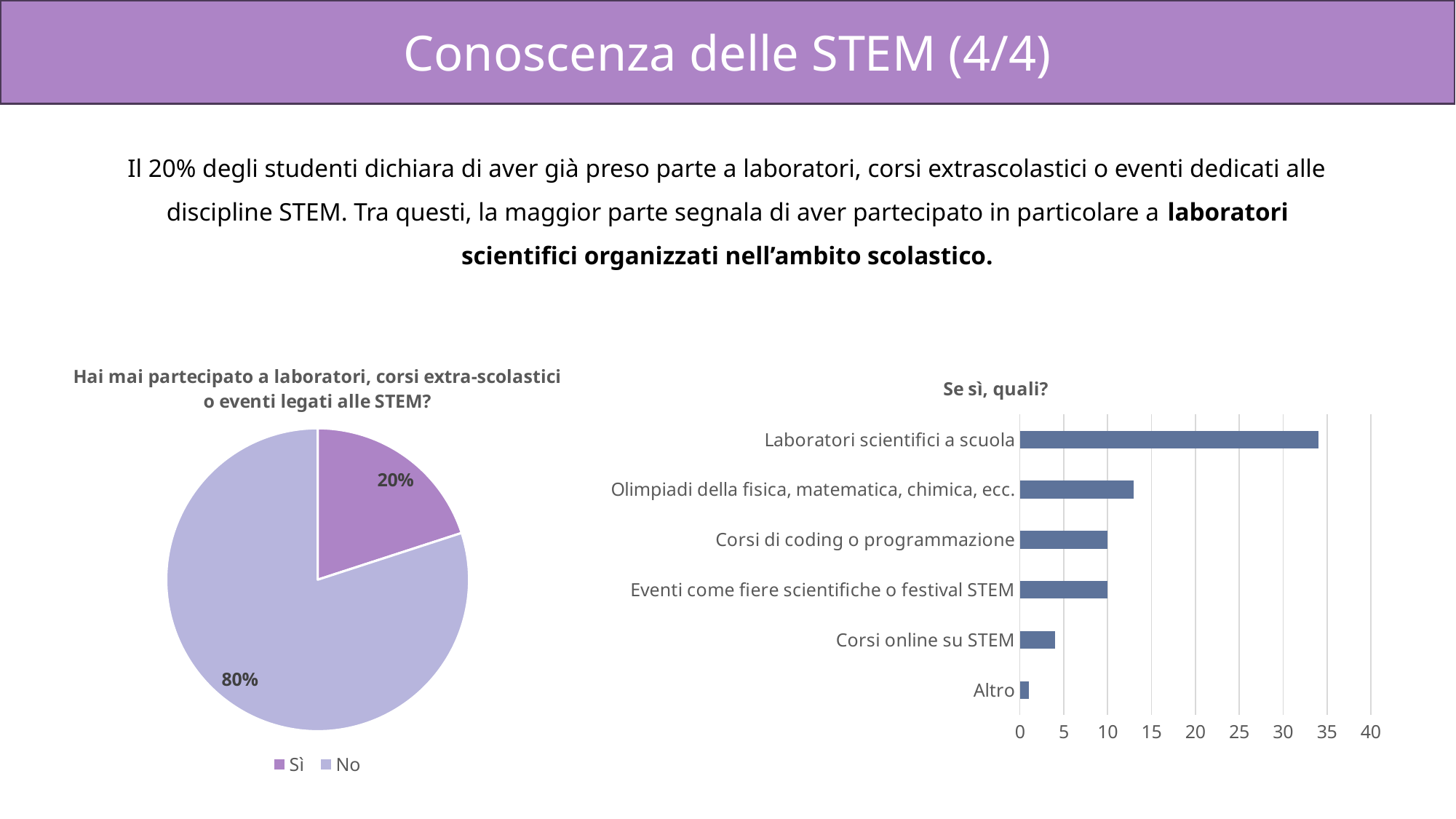
How many entries does the legend of the pie chart on the left list? 2 On the bar chart 'Se sì, quali?', is the value for 'Corsi online su STEM' greater or less than 5? less On the pie chart on the left, what is the difference in percentage points between 'No' and 'Sì'? 60 On the pie chart 'Hai mai partecipato a laboratori, corsi extra-scolastici o eventi legati alle STEM?', what percentage answered 'No'? 80% On the bar chart 'Se sì, quali?', which category has the lowest value? Altro On the bar chart 'Se sì, quali?', is the value for 'Laboratori scientifici a scuola' greater or less than 30? greater What kind of chart is the chart titled 'Se sì, quali?'? bar chart On the bar chart 'Se sì, quali?', which is larger: 'Olimpiadi della fisica, matematica, chimica, ecc.' or 'Corsi online su STEM'? Olimpiadi della fisica, matematica, chimica, ecc. How many categories are shown on the bar chart 'Se sì, quali?'? 6 On the bar chart 'Se sì, quali?', which category has the highest value? Laboratori scientifici a scuola On the pie chart 'Hai mai partecipato a laboratori, corsi extra-scolastici o eventi legati alle STEM?', what percentage answered 'Sì'? 20% On the pie chart on the left, which answer has the larger share? No